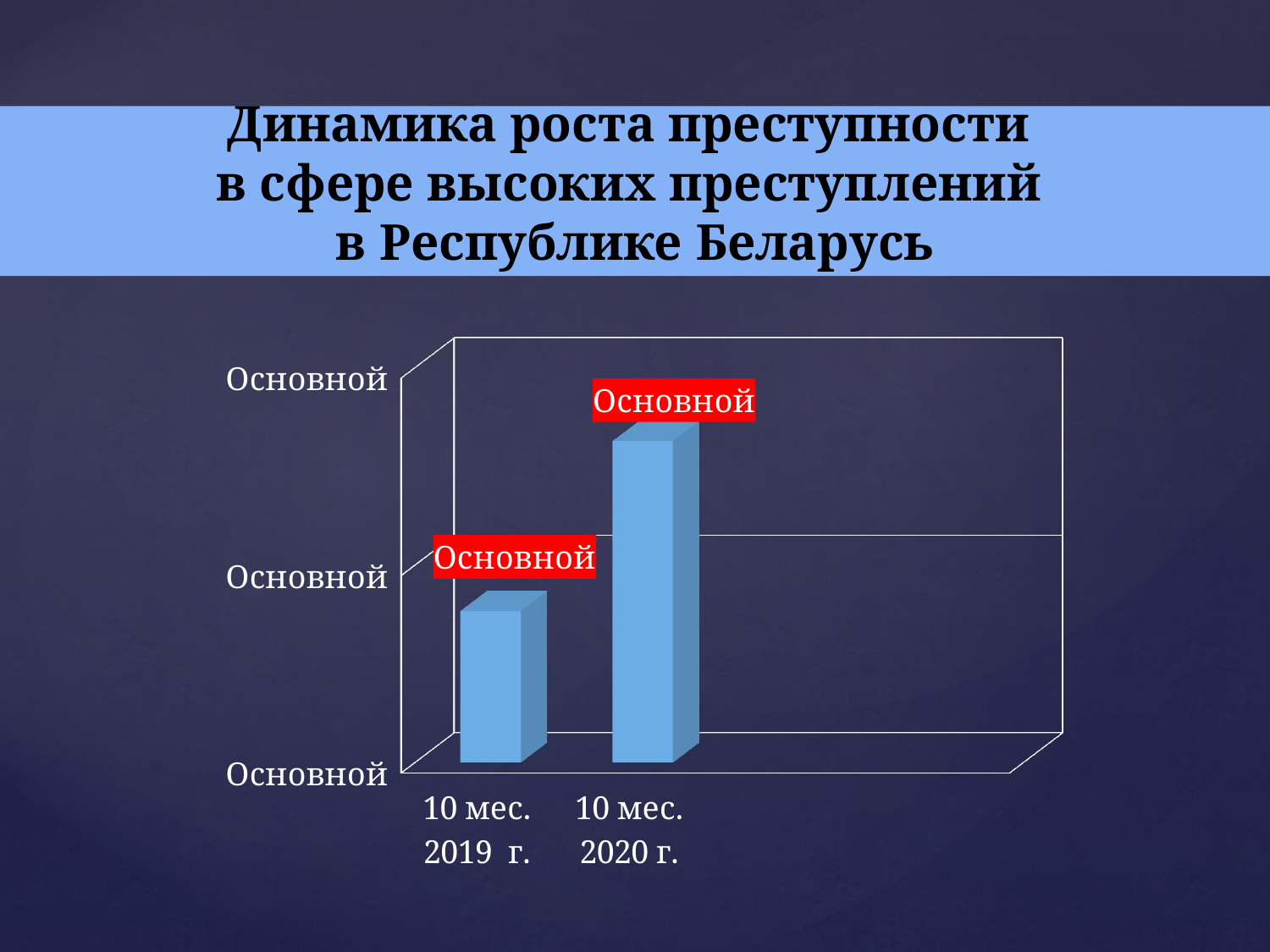
What colour are the bars in the chart? Light blue Which category has the highest bar? 10 мес. 2020 г. Which category has the lowest bar? 10 мес. 2019 г. Do the values rise or fall from 10 мес. 2019 г. to 10 мес. 2020 г.? Rise What kind of chart is shown on the slide? Bar chart Which is larger: the value for 10 мес. 2019 г. or the value for 10 мес. 2020 г.? 10 мес. 2020 г. How many bars (categories) does the chart show? 2 What is the title of the chart on the slide? Динамика роста преступности в сфере высоких преступлений в Республике Беларусь